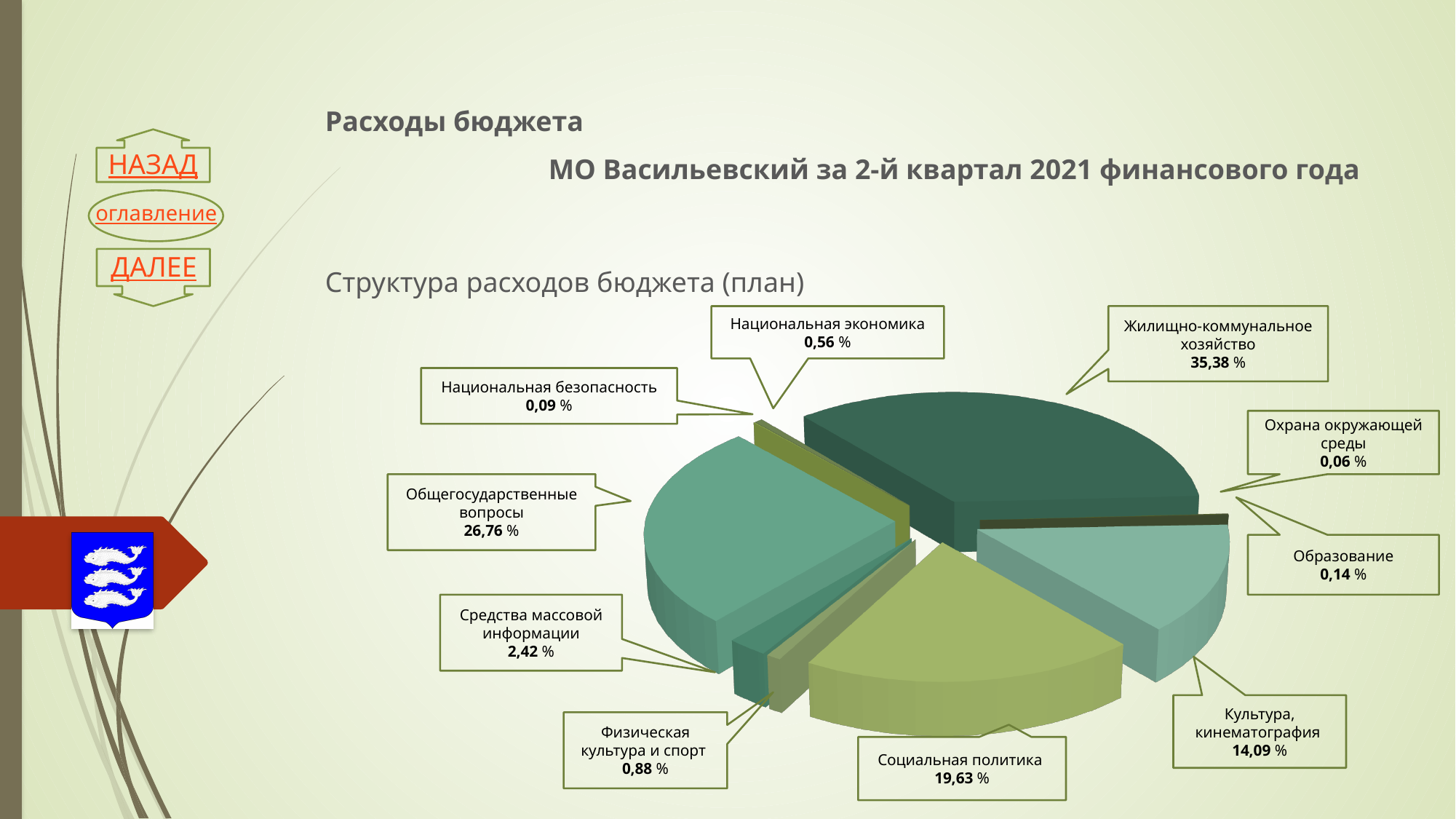
На сколько процентных пунктов доля «Общегосударственные вопросы» больше доли «Культура, кинематография»? 12,67 Какова доля категории «Средства массовой информации» на диаграмме? 2,42 % Какова доля категории «Физическая культура и спорт» на диаграмме? 0,88 % Какой тип диаграммы показан на слайде «Структура расходов бюджета (план)»? Круговая диаграмма Какая категория имеет наибольшую долю на диаграмме? Жилищно-коммунальное хозяйство Какова доля категории «Жилищно-коммунальное хозяйство» на диаграмме? 35,38 % Какова доля категории «Социальная политика» на диаграмме? 19,63 % Какова доля категории «Охрана окружающей среды» на диаграмме? 0,06 % Что больше: доля «Социальная политика» или доля «Культура, кинематография»? Социальная политика Какая категория имеет наименьшую долю на диаграмме? Охрана окружающей среды Как называется диаграмма на слайде? Структура расходов бюджета (план) Сколько категорий показано на круговой диаграмме? 10